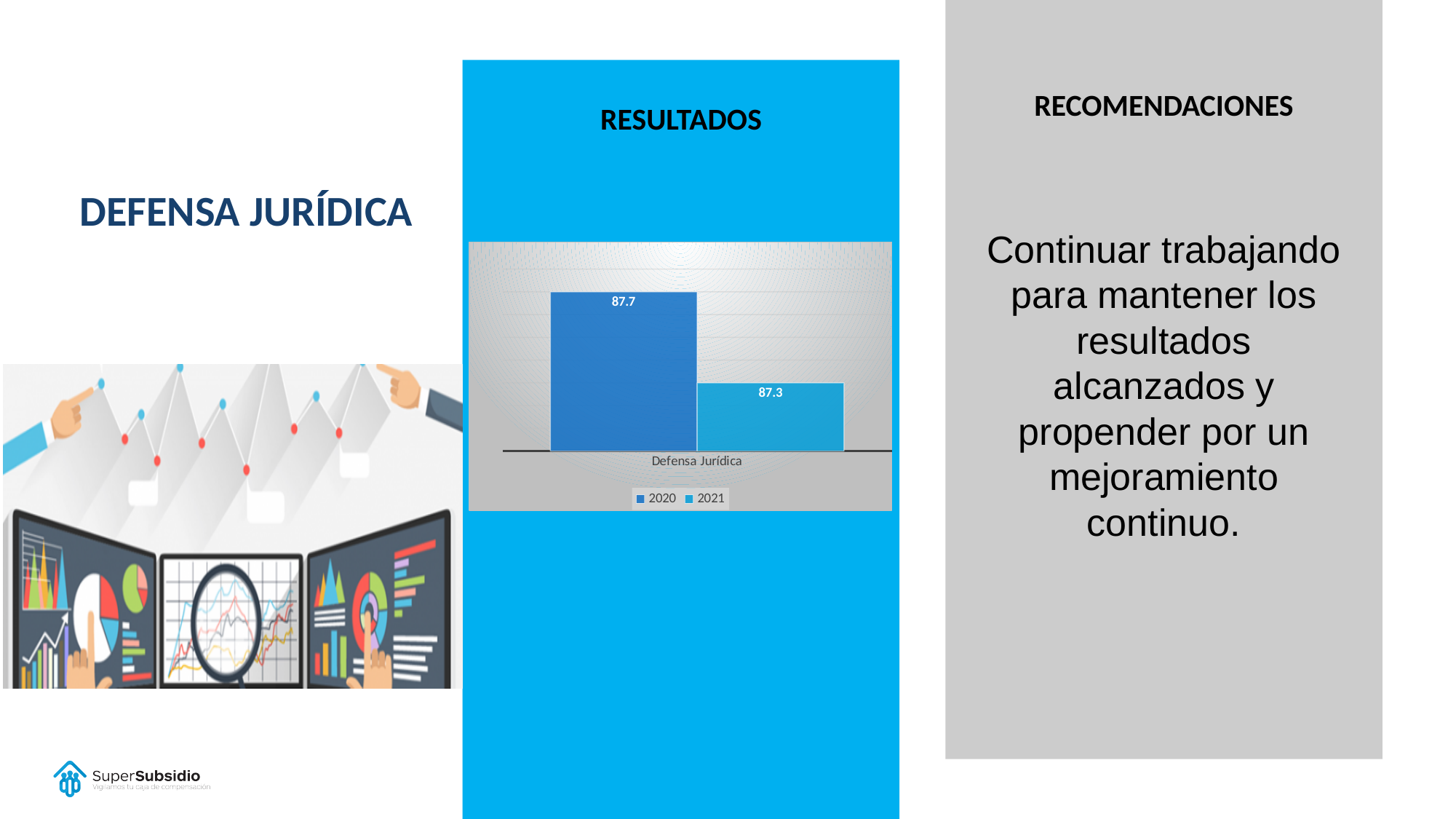
Did the value fall or rise from 2020 to 2021? Fall What kind of chart is shown on the slide? Bar chart How many series does the legend list? 2 Which year shows the lowest value in the chart? 2021 How many categories are shown on the x axis of the chart? 1 Which year shows the highest value in the chart? 2020 What is the value for 2021 in the chart? 87.3 Which series has the higher value, 2020 or 2021? 2020 What is the value for 2020 in the chart? 87.7 What is the difference between the 2020 value and the 2021 value? 0.4 What is the category label shown on the x axis of the chart? Defensa Jurídica Which years are listed in the chart legend? 2020 and 2021